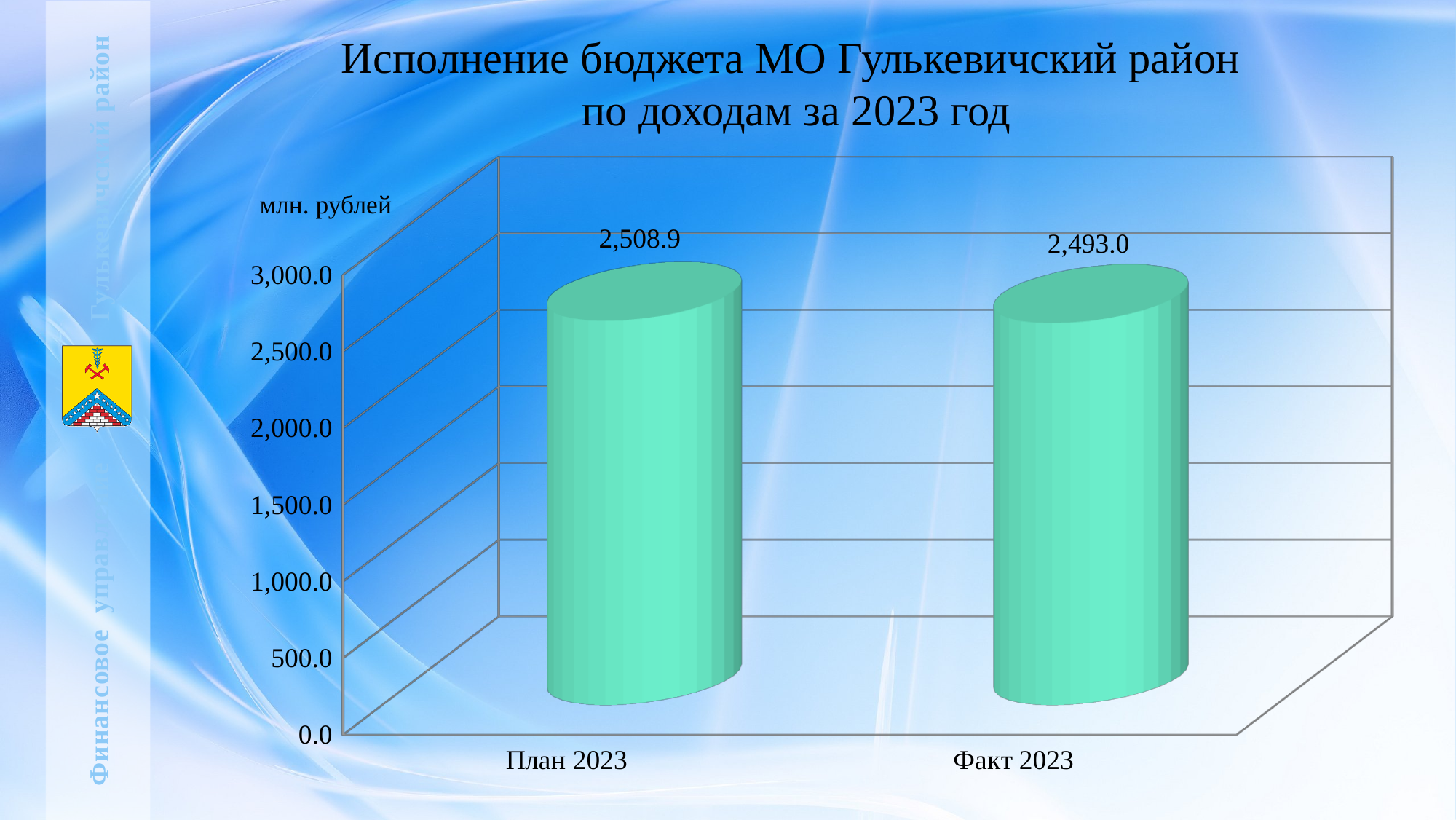
Which category has the higher value, План 2023 or Факт 2023? План 2023 Is the value for Факт 2023 greater or less than 2,000.0? greater What is the difference between the values for План 2023 and Факт 2023? 15.9 What is the title of the chart? Исполнение бюджета МО Гулькевичский район по доходам за 2023 год What kind of chart is shown on the slide? bar chart What is the value for Факт 2023? 2,493.0 Is the value for План 2023 greater or less than 3,000.0? less What is the value for План 2023? 2,508.9 How many categories are shown on the x axis? 2 Do the values rise or fall from План 2023 to Факт 2023? fall Which category has the lowest value? Факт 2023 What unit is shown for the values on the chart? млн. рублей